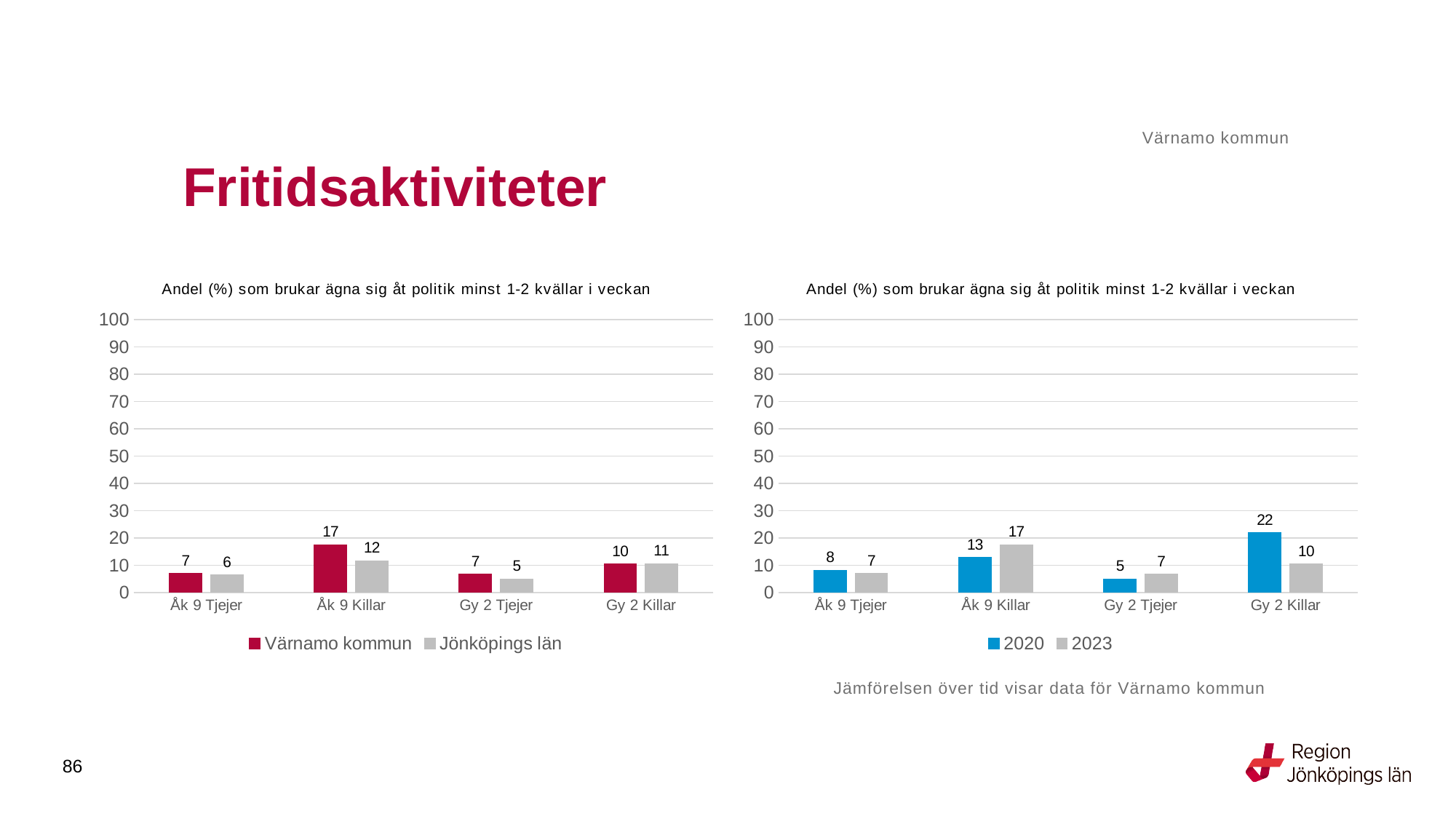
In the right chart, what is the difference between 2020 and 2023 for Gy 2 Killar? 12 In the left chart, what is the difference between Värnamo kommun and Jönköpings län for Åk 9 Killar? 5 How many categories are shown on the x axis of the left chart? 4 In the right chart, what is the value for 2020 for Gy 2 Killar? 22 In the left chart, what is the value for Värnamo kommun for Åk 9 Killar? 17 How many series does the legend of the right chart list? 2 In the right chart, what is the value for 2023 for Åk 9 Tjejer? 7 In the right chart, which is larger for Åk 9 Killar, 2020 or 2023? 2023 In the left chart, what is the value for Jönköpings län for Gy 2 Tjejer? 5 In the left chart, which category has the highest value for Värnamo kommun? Åk 9 Killar In the right chart, which category has the lowest value for 2020? Gy 2 Tjejer What kind of chart is the left chart? Bar chart